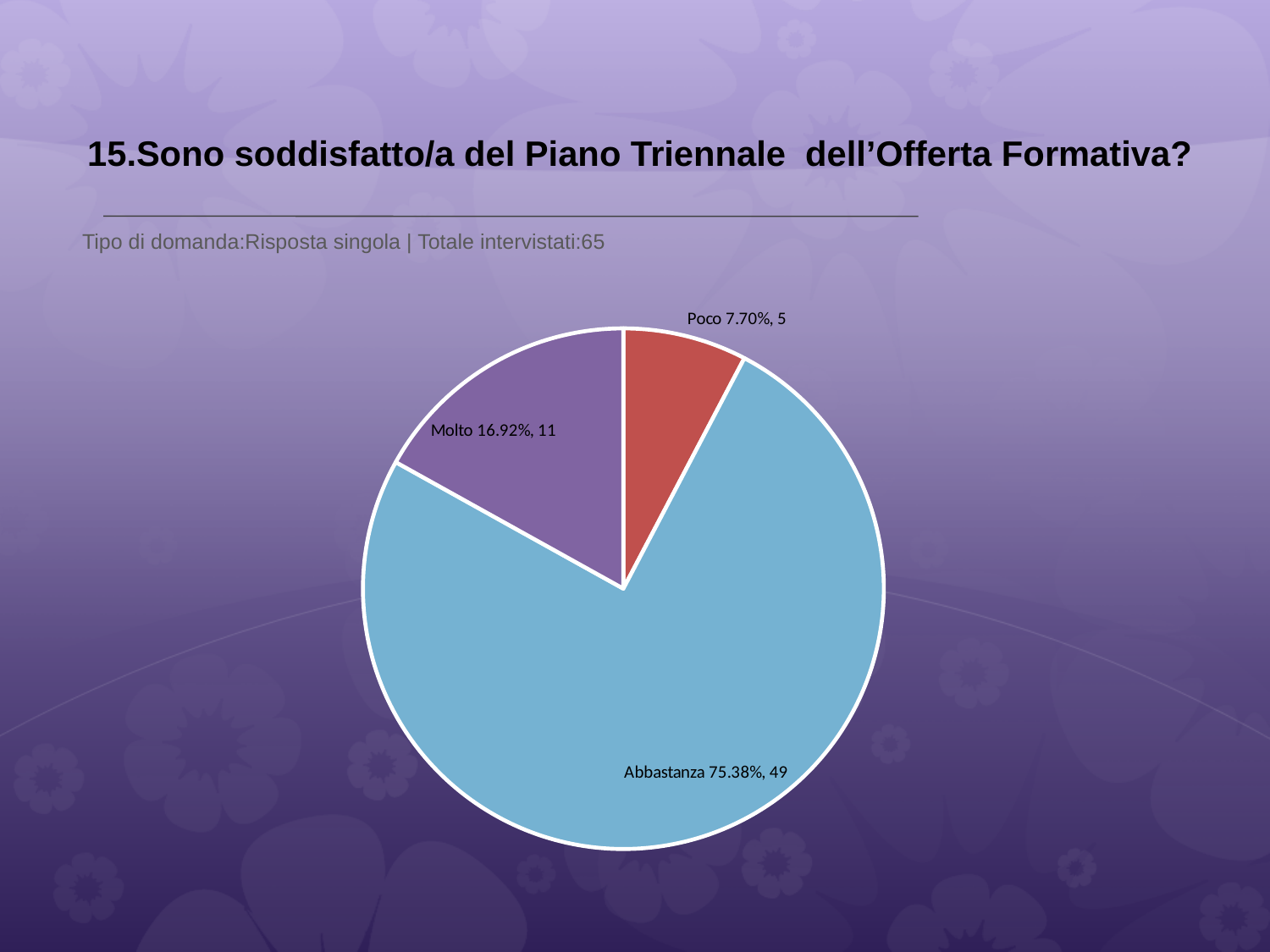
How many respondents answered Poco? 5 How many respondents answered Abbastanza? 49 How many respondents answered Molto? 11 What percentage share does the Poco slice have? 7.70% Which is larger, the Molto slice or the Poco slice? Molto What percentage share does the Abbastanza slice have? 75.38% What kind of chart is shown on the slide? pie chart What percentage share does the Molto slice have? 16.92% What is the difference in respondent count between Molto and Poco? 6 Which category has the largest slice? Abbastanza How many slices does the pie chart have? 3 Which category has the smallest slice? Poco